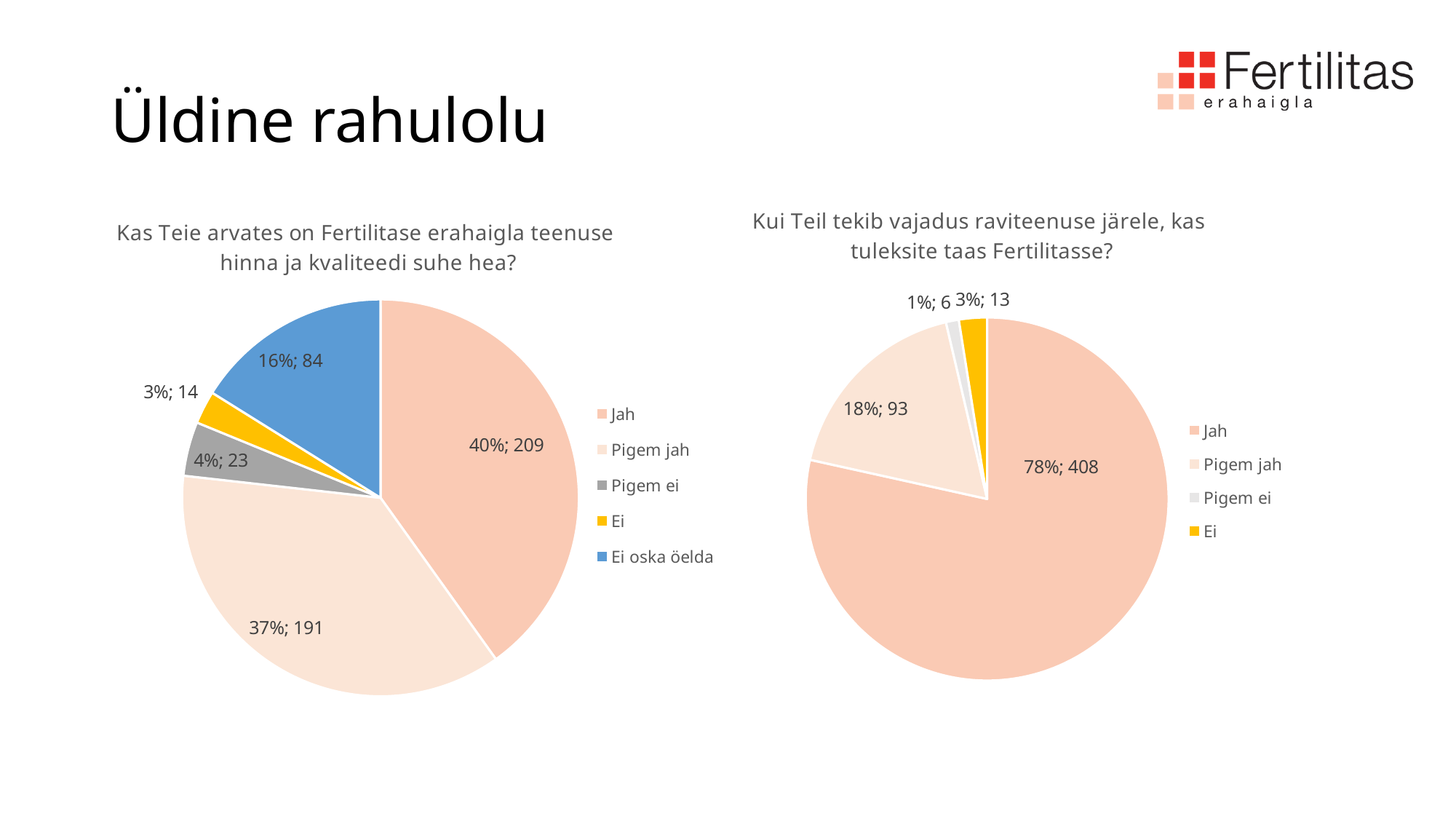
In the left chart, what is the difference in count between "Jah" and "Pigem jah"? 18 In the left chart ("Kas Teie arvates on Fertilitase erahaigla teenuse hinna ja kvaliteedi suhe hea?"), what is the count for "Jah"? 209 In the right chart, which is larger, the count for "Ei" or the count for "Pigem ei"? Ei In the left chart, what percentage share does "Pigem jah" have? 37% In the left chart, which category has the smallest slice? Ei In the right chart, what percentage share does "Pigem jah" have? 18% In the right chart, which category has the largest slice? Jah In the right chart ("Kui Teil tekib vajadus raviteenuse järele, kas tuleksite taas Fertilitasse?"), what is the count for "Jah"? 408 Which legend entry appears in the left chart but not in the right chart? Ei oska öelda In the left chart, how many categories does the legend list? 5 In the left chart, what is the count for "Ei oska öelda"? 84 What type of chart is used on the right side of the slide? Pie chart